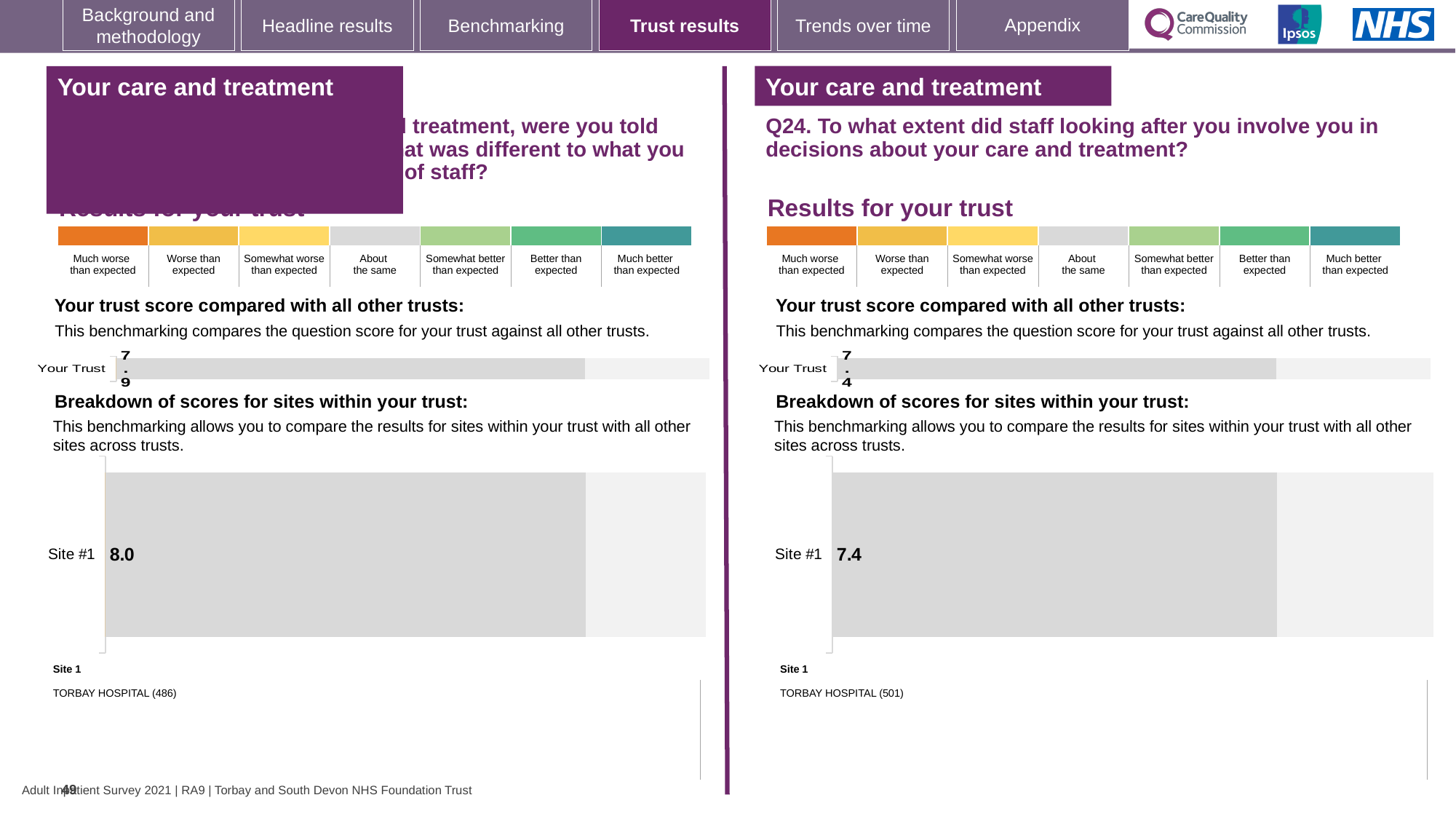
In the left panel's 'Breakdown of scores for sites within your trust' chart, what is the score for Site #1? 8.0 Which panel shows the higher Your Trust score, the left panel or the right panel (Q24)? Left panel In the right panel (Q24) 'Breakdown of scores for sites within your trust' chart, what is the score for Site #1? 7.4 In the right panel (Q24) 'Your trust score compared with all other trusts' chart, what is the score for Your Trust? 7.4 What type of chart is used to show the Site #1 score in the left panel? Bar chart In the left panel, what is the difference between the Site #1 score and the Your Trust score? 0.1 In the left panel's 'Your trust score compared with all other trusts' chart, what is the score for Your Trust? 7.9 How many sites are shown in the right panel's 'Breakdown of scores for sites within your trust' chart? 1 What is the difference between the Site #1 score in the left panel and the Site #1 score in the right panel (Q24)? 0.6 Which panel shows the higher Site #1 score, the left panel or the right panel (Q24)? Left panel In the left panel, which is higher: the Your Trust score or the Site #1 score? Site #1 In the right panel (Q24), which hospital is listed as Site 1 below the breakdown chart? TORBAY HOSPITAL (501)